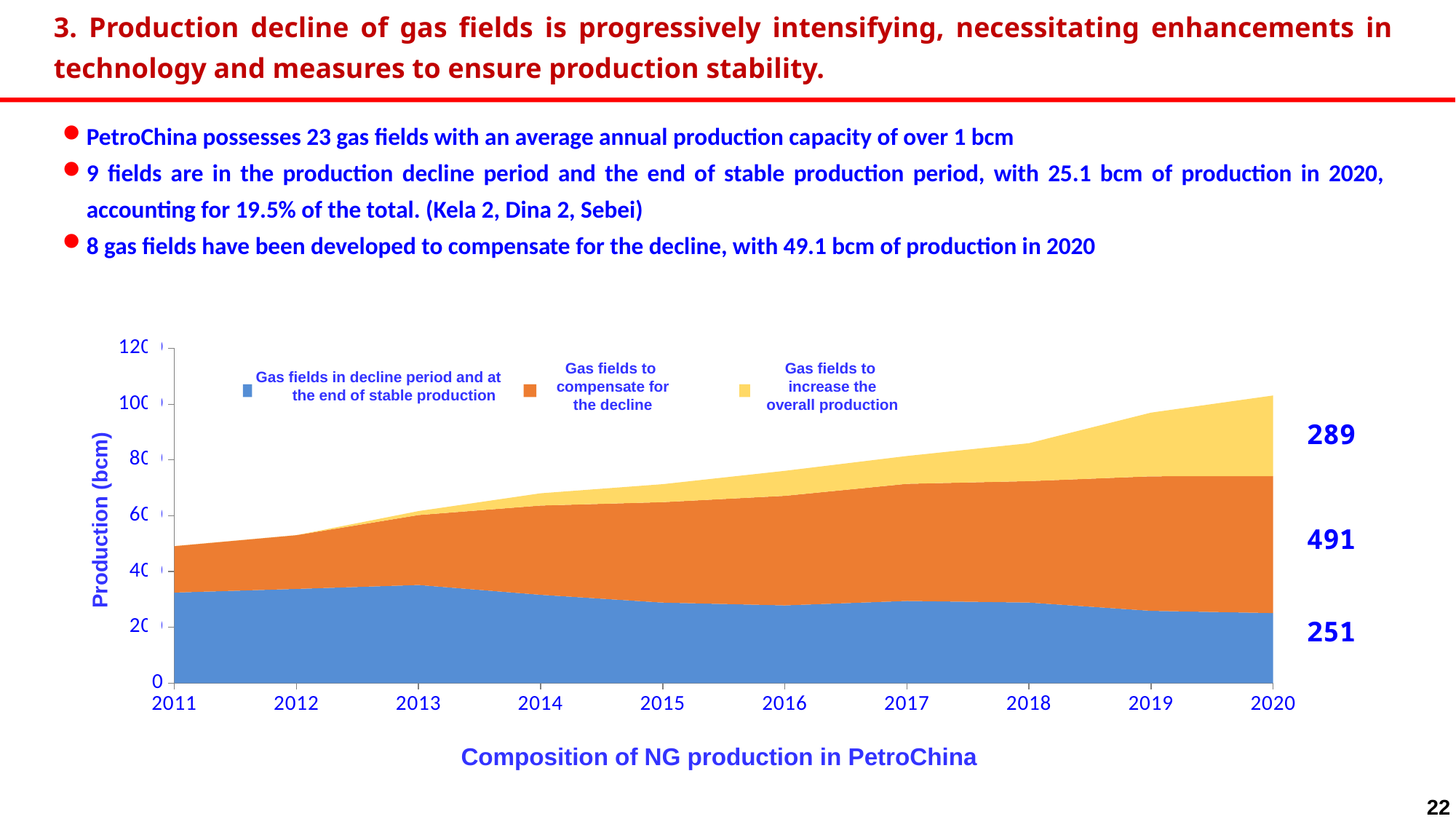
What kind of chart is shown on the slide? Stacked area chart What is the title of the chart? Composition of NG production in PetroChina Which year has the larger value for 'Gas fields in decline period and at the end of stable production', 2013 or 2020? 2013 Is the total production in 2011 greater or less than 60? less Is the total production in 2020 greater or less than 100? greater Does the total production rise or fall from 2011 to 2020? Rise Is the value for 'Gas fields in decline period and at the end of stable production' in 2011 greater or less than 40? less What is the label of the y axis? Production (bcm) How many years are shown along the x axis? 10 How many series does the legend list? 3 Which year has the larger total production, 2011 or 2020? 2020